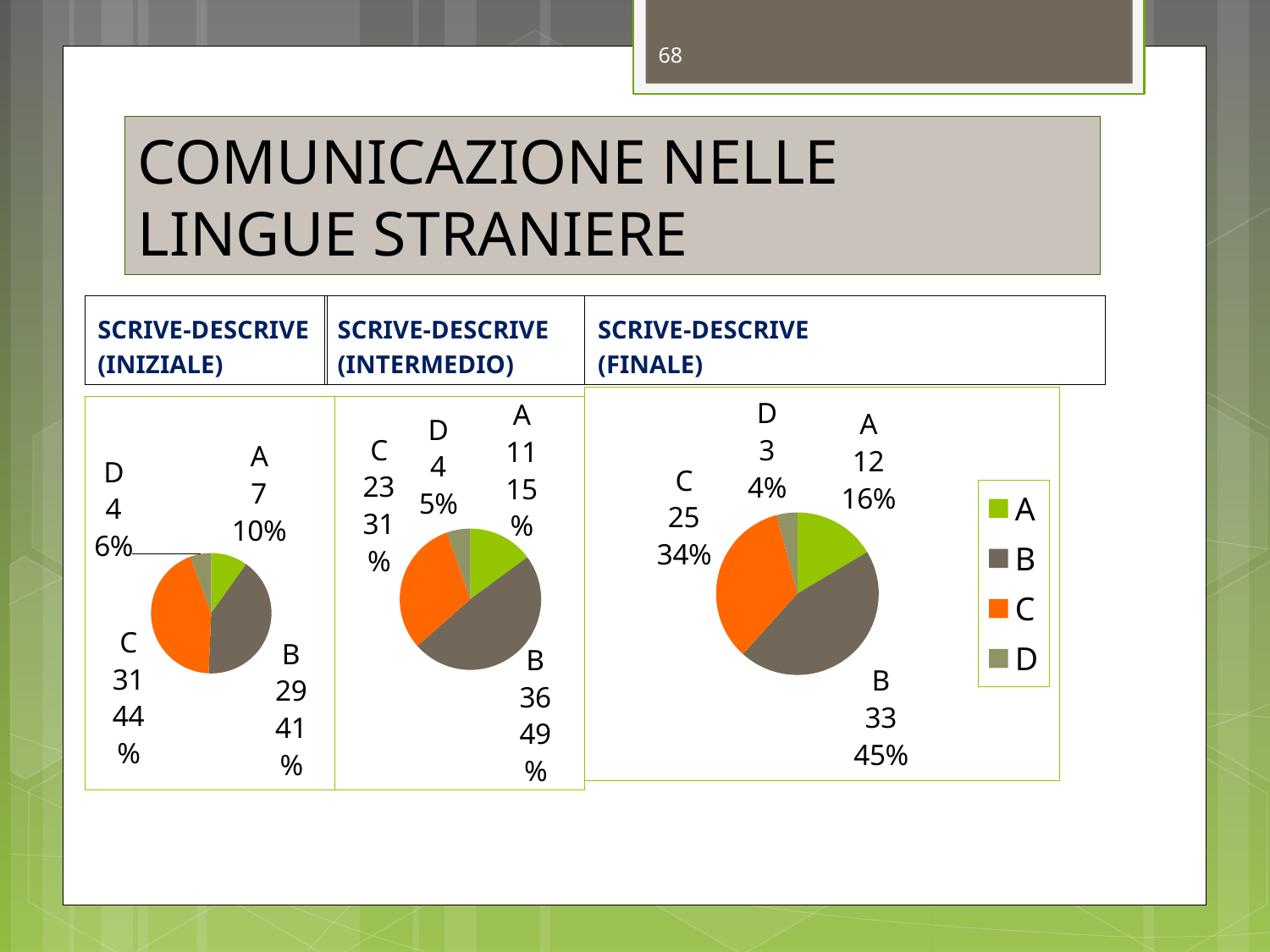
How many categories does the SCRIVE-DESCRIVE (FINALE) pie chart show? 4 In the SCRIVE-DESCRIVE (FINALE) pie chart, what count is shown for category C? 25 In the SCRIVE-DESCRIVE (INIZIALE) pie chart, which category has the smallest share? D In the SCRIVE-DESCRIVE (FINALE) pie chart, which category has the largest share? B In the SCRIVE-DESCRIVE (INIZIALE) pie chart, what count is shown for category B? 29 What type of chart is used under SCRIVE-DESCRIVE (INTERMEDIO)? Pie chart In the legend next to the SCRIVE-DESCRIVE (FINALE) chart, which category is shown in orange? C In the SCRIVE-DESCRIVE (INIZIALE) pie chart, what percentage is shown for category C? 44% In the SCRIVE-DESCRIVE (INTERMEDIO) pie chart, what percentage is shown for category B? 49% In the SCRIVE-DESCRIVE (FINALE) pie chart, which is larger, the share for A or the share for C? C In the SCRIVE-DESCRIVE (INTERMEDIO) pie chart, what is the difference in percentage points between category B and category C? 18 How many entries does the legend next to the SCRIVE-DESCRIVE (FINALE) chart list? 4